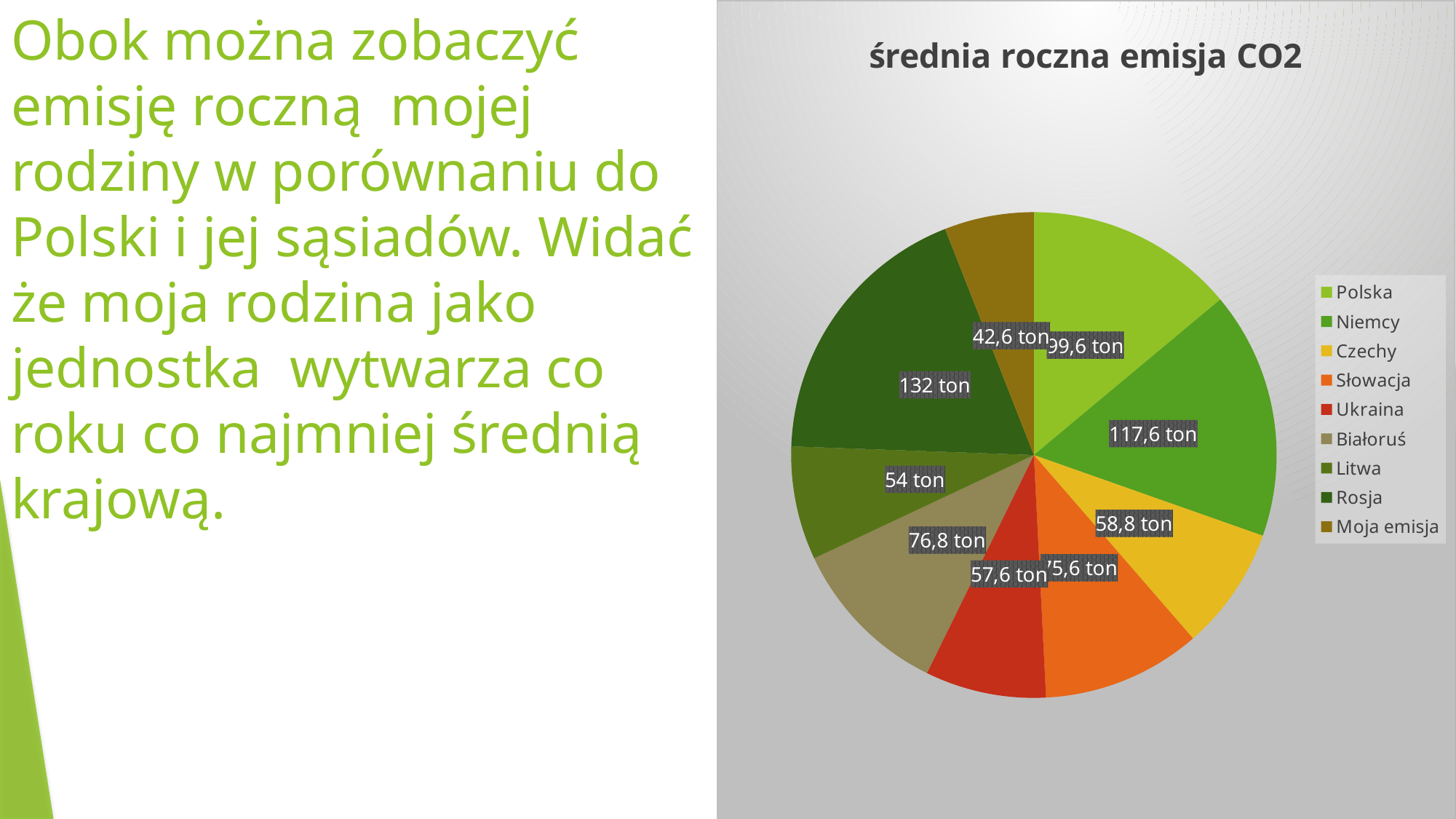
What is the value for Białoruś? 76,8 ton What is the value for Litwa? 54 ton What is the title of the chart? średnia roczna emisja CO2 Which category has the largest slice? Rosja What is the value for Niemcy? 117,6 ton What is the value for Moja emisja? 42,6 ton How many categories does the pie chart have? 9 Which is larger, the value for Białoruś or the value for Litwa? Białoruś What is the difference between the values for Rosja and Niemcy? 14,4 ton What is the value for Rosja? 132 ton Which category has the smallest slice? Moja emisja What kind of chart is shown on the slide? pie chart